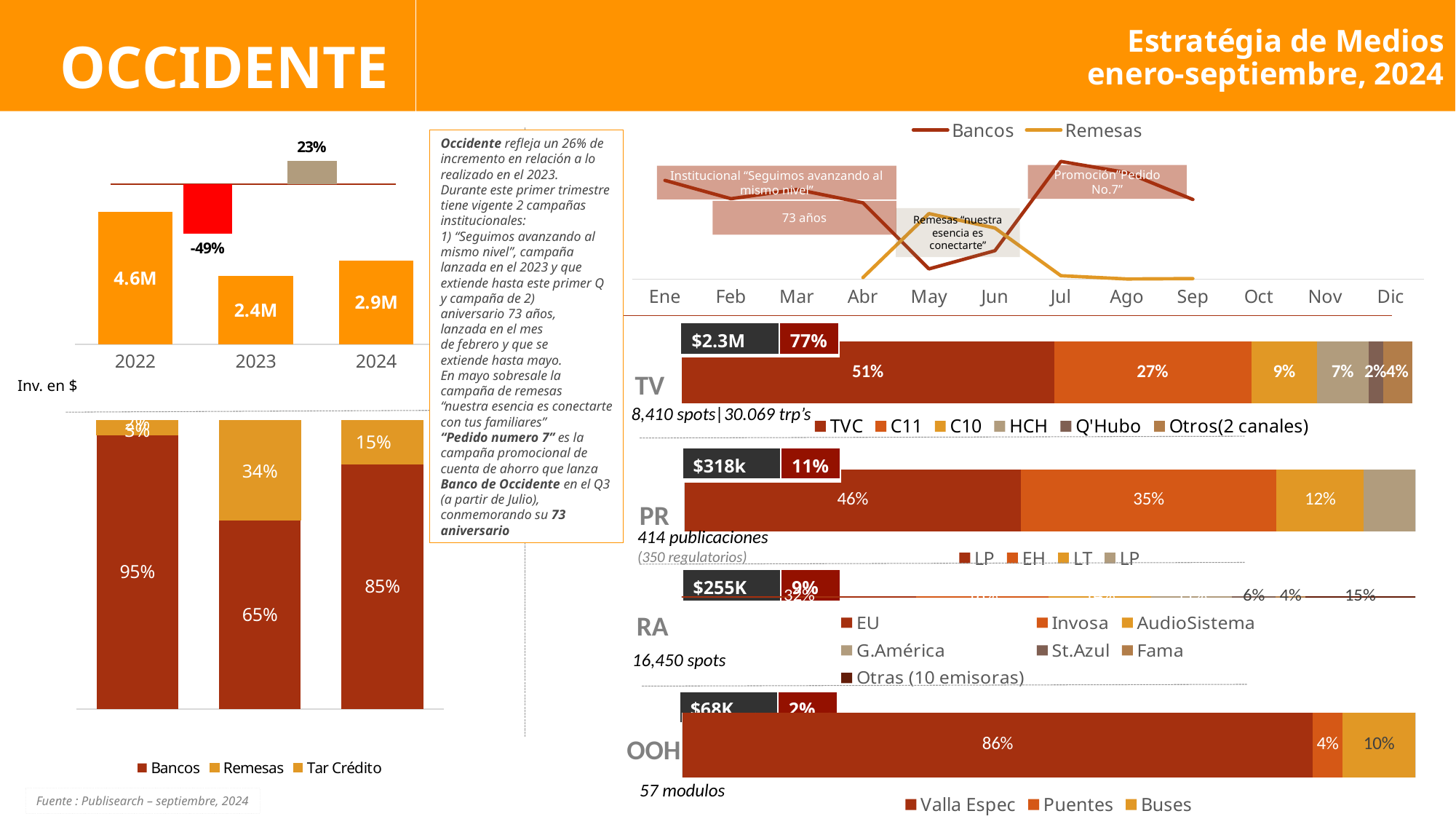
In the investment bar chart on the left (Inv. en $), is the value for 2024 larger or smaller than the value for 2022? smaller In the TV bar on the right, what share does TVC have? 51% In the TV bar on the right, what is the difference between the TVC share and the C11 share? 24% In the OOH bar on the right, what share does Buses have? 10% In the stacked bar chart at the bottom left, what share does Remesas have in 2024? 15% In the investment bar chart on the left (Inv. en $), what is the value for 2022? 4.6M In the investment bar chart on the left (Inv. en $), which year has the lowest investment? 2023 In the investment bar chart on the left (Inv. en $), what percentage change is shown between 2023 and 2024? 23% In the stacked bar chart at the bottom left, what share does Bancos have in 2023? 65% What type of chart is the Bancos vs Remesas chart at the top right? line chart How many series does the legend of the stacked bar chart at the bottom left list? 3 In the OOH bar on the right, which category has the largest share? Valla Espec